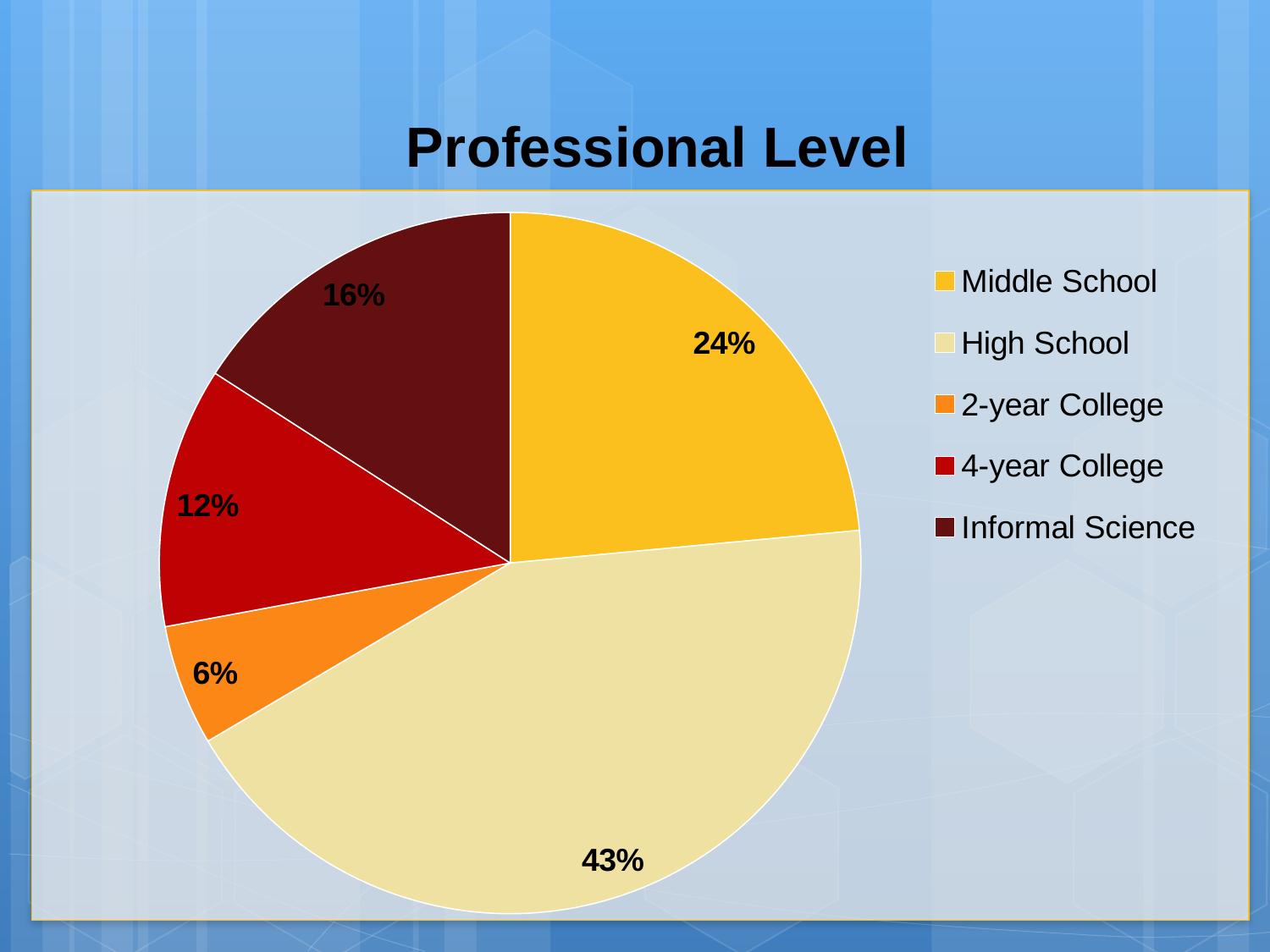
What percentage of the pie is High School? 43% What is the difference in percentage points between High School and Middle School? 19 What colour is the Informal Science slice? Dark red Which category has the smallest share of the pie? 2-year College What percentage of the pie is Middle School? 24% What percentage of the pie is 2-year College? 6% What is the title of the chart? Professional Level What percentage of the pie is Informal Science? 16% What type of chart is shown on the slide? Pie chart Which category has the largest share of the pie? High School How many categories does the pie chart show? 5 Which is larger, the share for 4-year College or the share for Informal Science? Informal Science